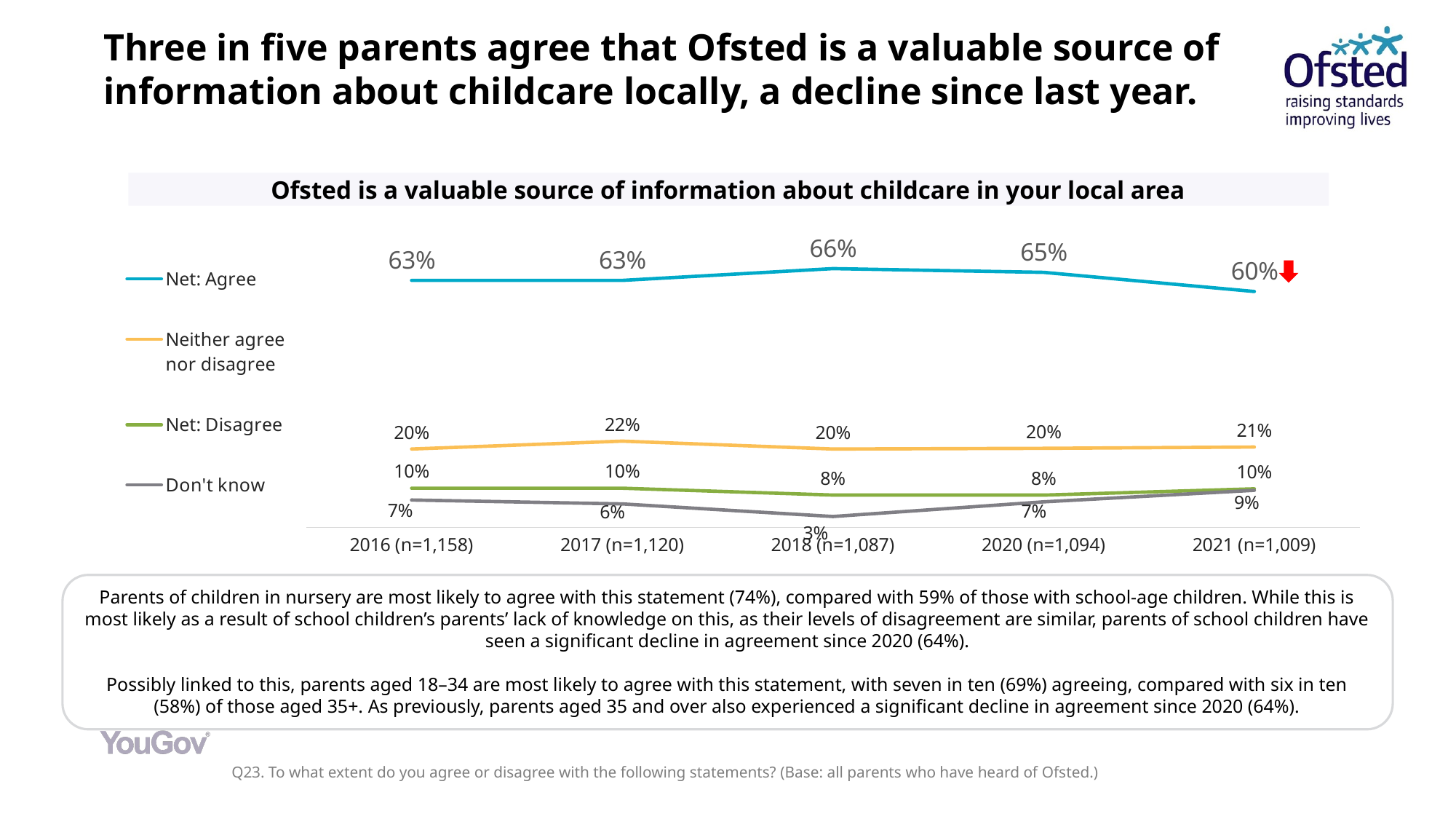
How many series does the legend list? 4 In which year was Net: Agree highest? 2018 Did Net: Agree rise or fall between 2020 and 2021? Fall How many years are shown on the x axis? 5 What is the Net: Agree value for 2021? 60% What is the Neither agree nor disagree value for 2017? 22% What is the Don't know value for 2018? 3% What is the title of the chart? Ofsted is a valuable source of information about childcare in your local area In which year was Don't know lowest? 2018 Which is larger in 2021, Net: Disagree or Don't know? Net: Disagree What type of chart is shown on the slide? Line chart What is the difference between the Net: Agree values for 2018 and 2021? 6 percentage points